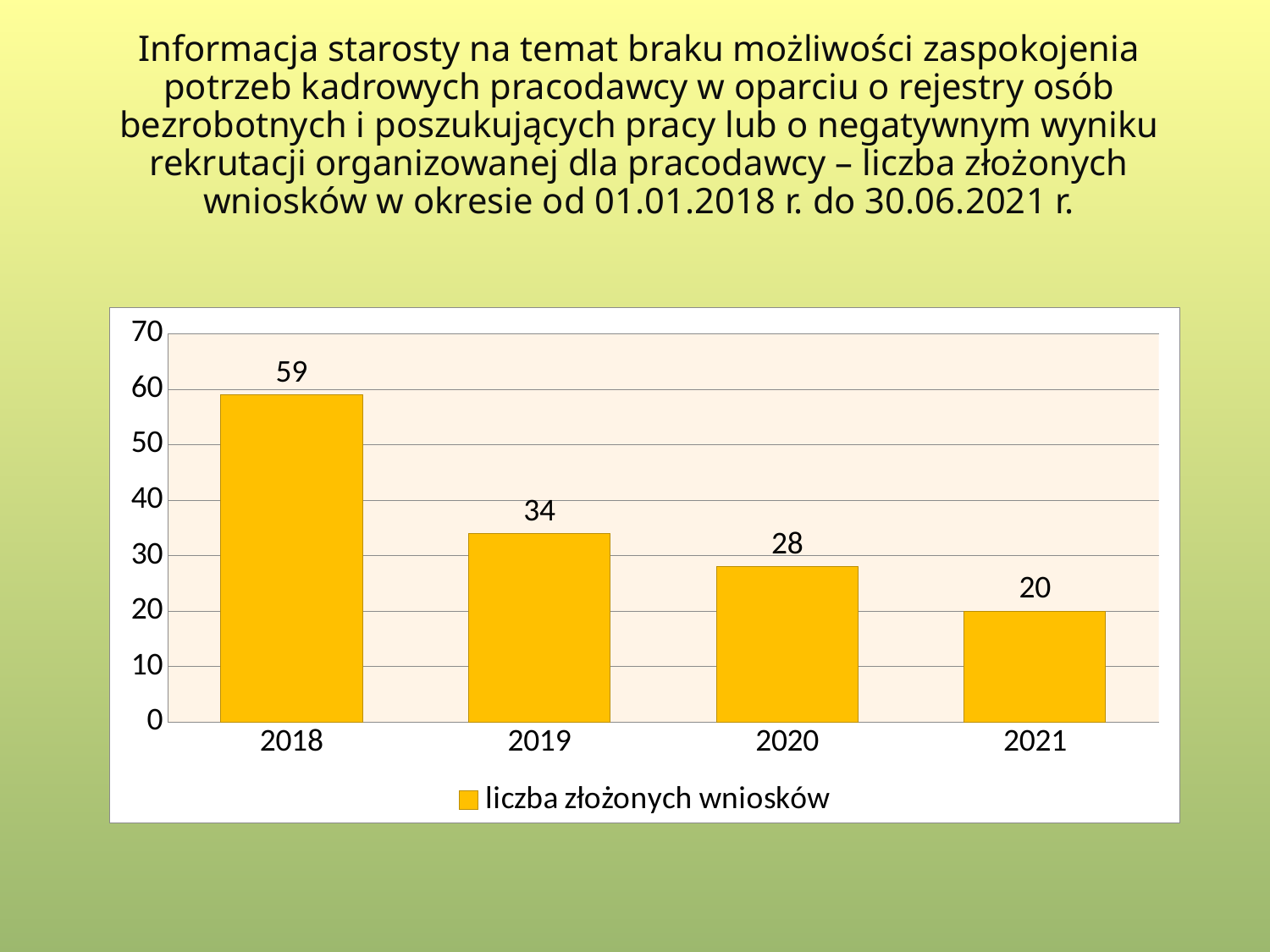
Which year has the lowest value? 2021 How many years are shown on the x axis? 4 What is the value for 2018? 59 Which is larger, the value for 2019 or the value for 2020? 2019 What is the difference between the values for 2018 and 2019? 25 Which year has the highest value? 2018 Do the values rise or fall from 2018 to 2021? fall What is the difference between the values for 2020 and 2021? 8 What is the value for 2021? 20 What kind of chart is shown? bar chart What is the value for 2020? 28 What is the value for 2019? 34